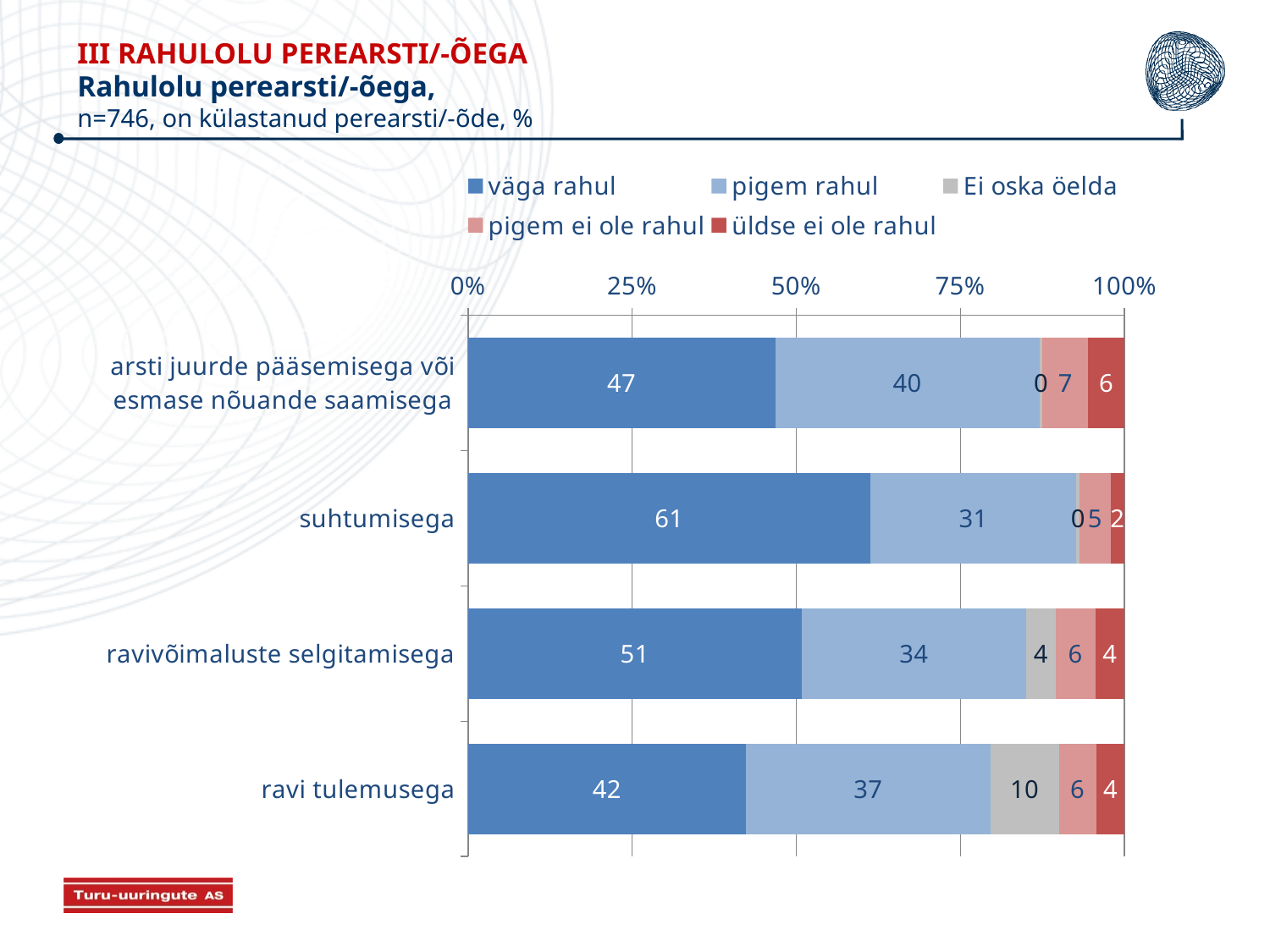
What is the 'väga rahul' value for 'suhtumisega'? 61 Which category has the highest 'väga rahul' value? suhtumisega Which is larger: the 'pigem rahul' value for 'arsti juurde pääsemisega või esmase nõuande saamisega' or for 'ravivõimaluste selgitamisega'? arsti juurde pääsemisega või esmase nõuande saamisega Which category has the lowest 'väga rahul' value? ravi tulemusega What kind of chart is shown on the slide? stacked bar chart How many categories are plotted on the chart? 4 How many series does the legend list? 5 What is the 'pigem rahul' value for 'ravi tulemusega'? 37 What is the 'üldse ei ole rahul' value for 'arsti juurde pääsemisega või esmase nõuande saamisega'? 6 What is the 'Ei oska öelda' value for 'ravi tulemusega'? 10 What is the total of the stacked bar for 'ravivõimaluste selgitamisega'? 99 What is the difference between the 'väga rahul' values for 'suhtumisega' and 'ravi tulemusega'? 19